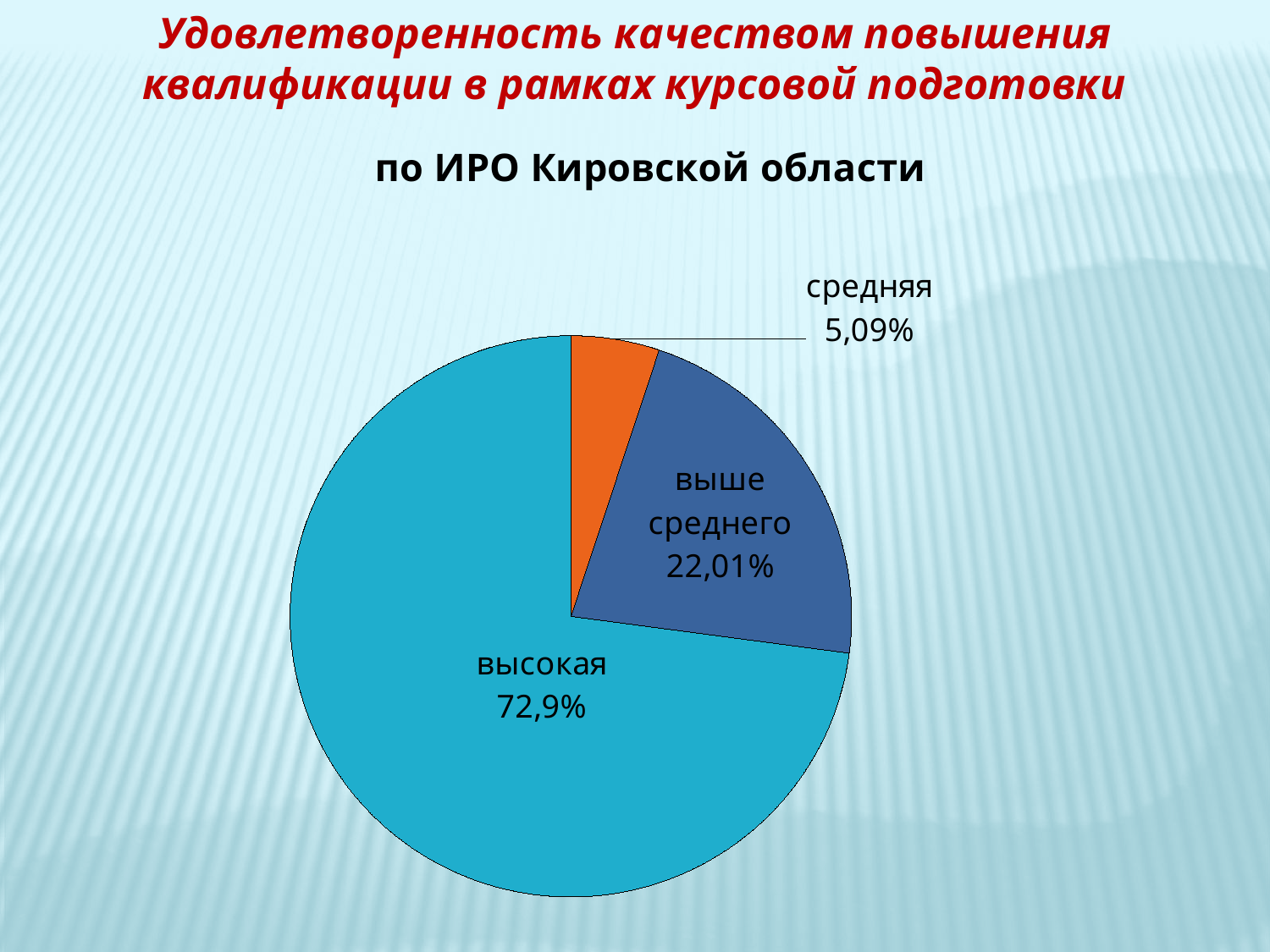
Which category has the largest share of the pie? высокая Which is larger, the "выше среднего" slice or the "средняя" slice? выше среднего What colour is the "высокая" slice? light blue (cyan) What is the value for the "выше среднего" slice? 22,01% What is the difference between the "высокая" and "выше среднего" values? 50,89% What is the value for the "высокая" slice? 72,9% What is the difference between the "выше среднего" and "средняя" values? 16,92% What is the value for the "средняя" slice? 5,09% How many slices does the pie chart have? 3 Which category has the smallest share of the pie? средняя What type of chart is shown on the slide? pie chart What is the subtitle shown above the chart? по ИРО Кировской области